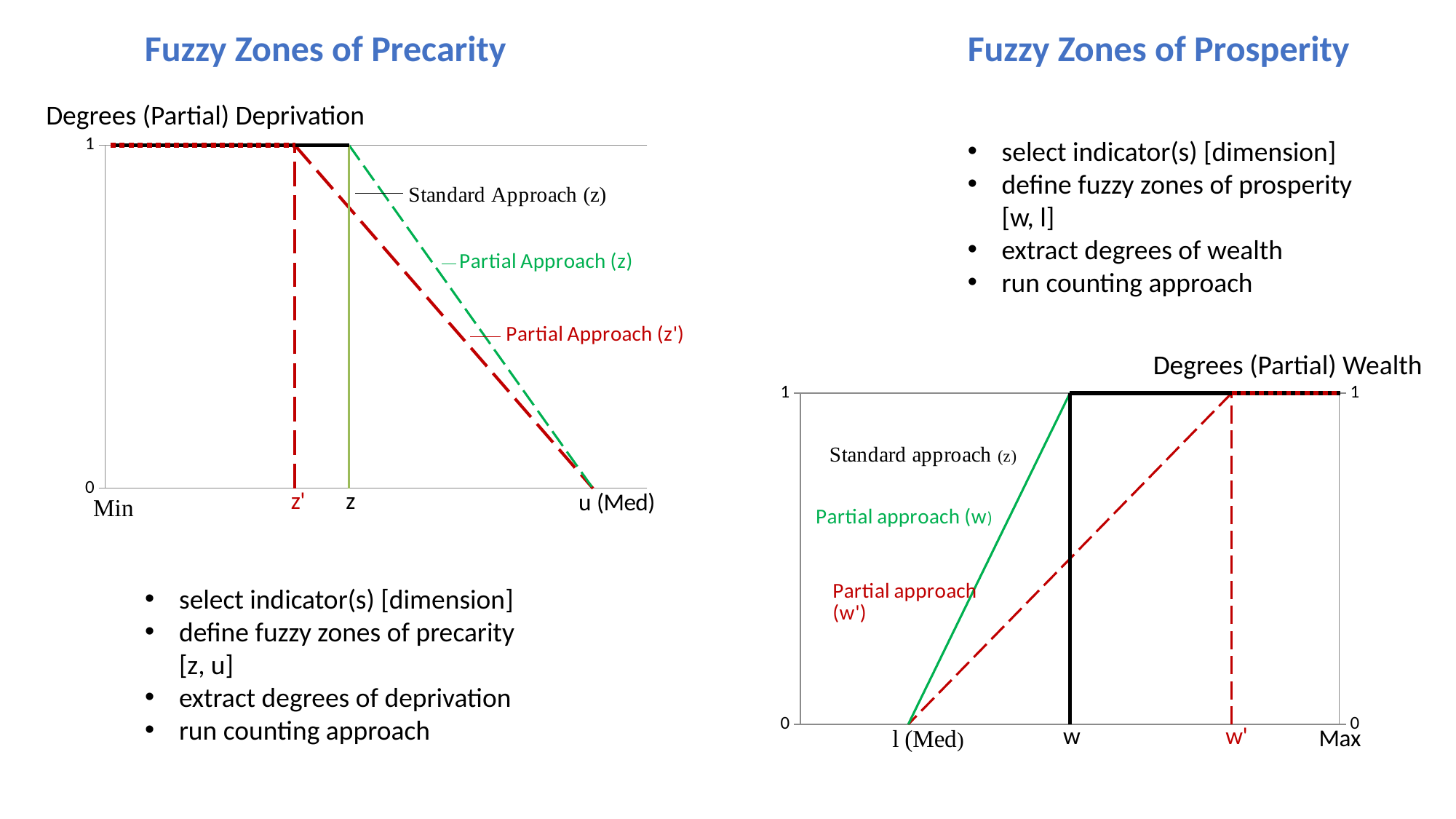
What kind of chart is the Fuzzy Zones of Precarity chart on the left? line chart In the Fuzzy Zones of Prosperity chart, what is the degree of wealth at l (Med)? 0 What is the y-axis label of the Fuzzy Zones of Prosperity chart? Degrees (Partial) Wealth In the Fuzzy Zones of Precarity chart, what is the degree of deprivation for the Partial Approach (z) at u (Med)? 0 In the Fuzzy Zones of Prosperity chart, how many approaches (series) are plotted? 3 In the Fuzzy Zones of Precarity chart, what colour is the Partial Approach (z') line? red In the Fuzzy Zones of Prosperity chart, what is the degree of wealth at Max? 1 In the Fuzzy Zones of Prosperity chart, do the partial approach lines rise or fall as the x axis moves from l (Med) toward w'? rise In the Fuzzy Zones of Precarity chart, what is the degree of deprivation at Min? 1 In the Fuzzy Zones of Precarity chart, how many approaches (series) are plotted? 3 In the Fuzzy Zones of Precarity chart, at x = z, which is higher: Partial Approach (z) or Partial Approach (z')? Partial Approach (z) In the Fuzzy Zones of Precarity chart, do the partial approach lines rise or fall as the x axis moves from z toward u (Med)? fall